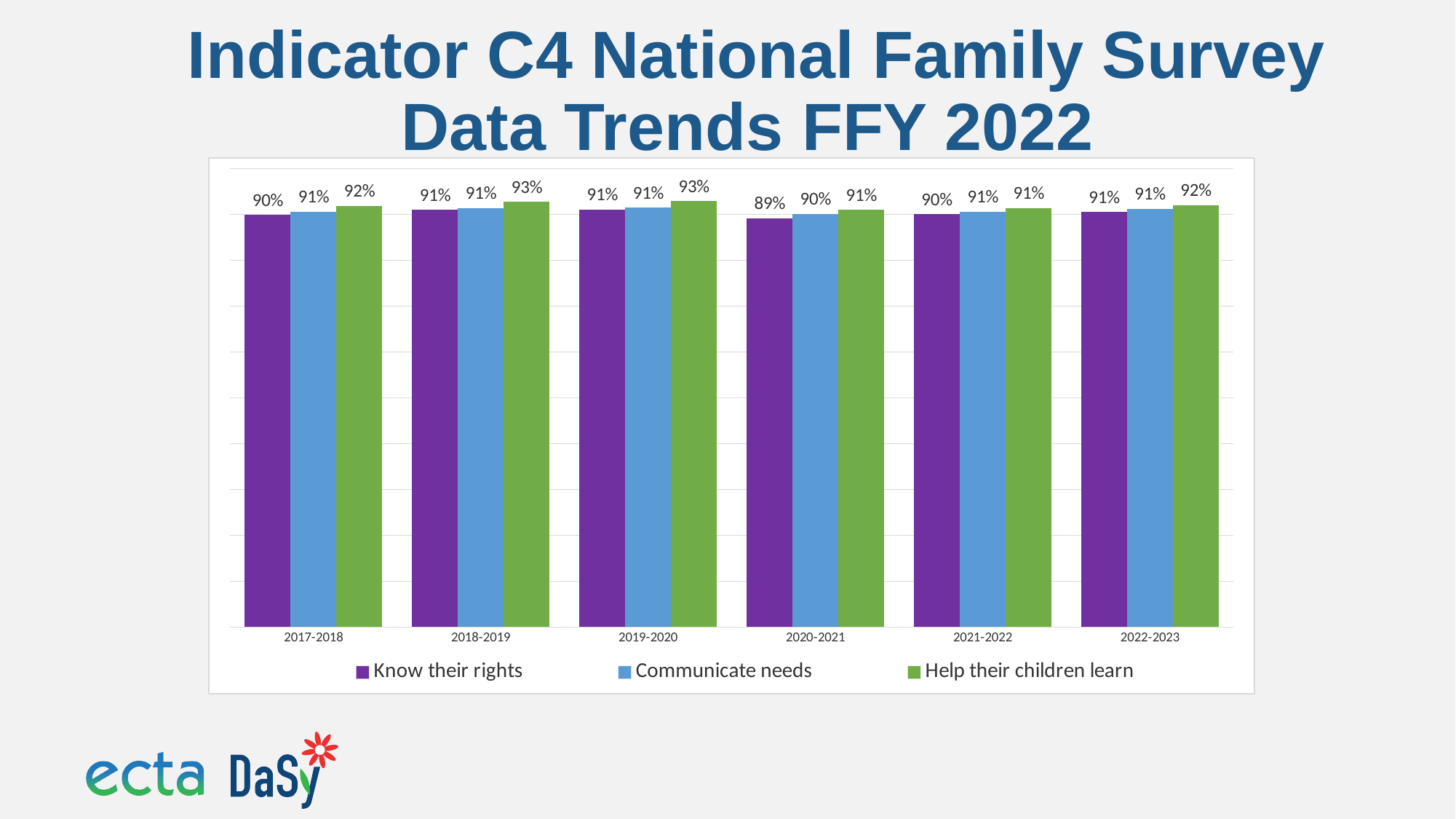
What is the value for Communicate needs in 2020-2021? 90% What is the value for Help their children learn in 2019-2020? 93% Which series is shown in green in the legend? Help their children learn What is the difference between Help their children learn and Know their rights in 2019-2020? 2 percentage points How many year categories are shown on the x axis? 6 What type of chart is shown on the slide? bar chart In which year is the value for Know their rights lowest? 2020-2021 How many series does the legend list? 3 In 2020-2021, which is larger: Know their rights or Help their children learn? Help their children learn What is the value for Know their rights in 2017-2018? 90% What is the value for Help their children learn in 2022-2023? 92% In which year is the value for Communicate needs lowest? 2020-2021